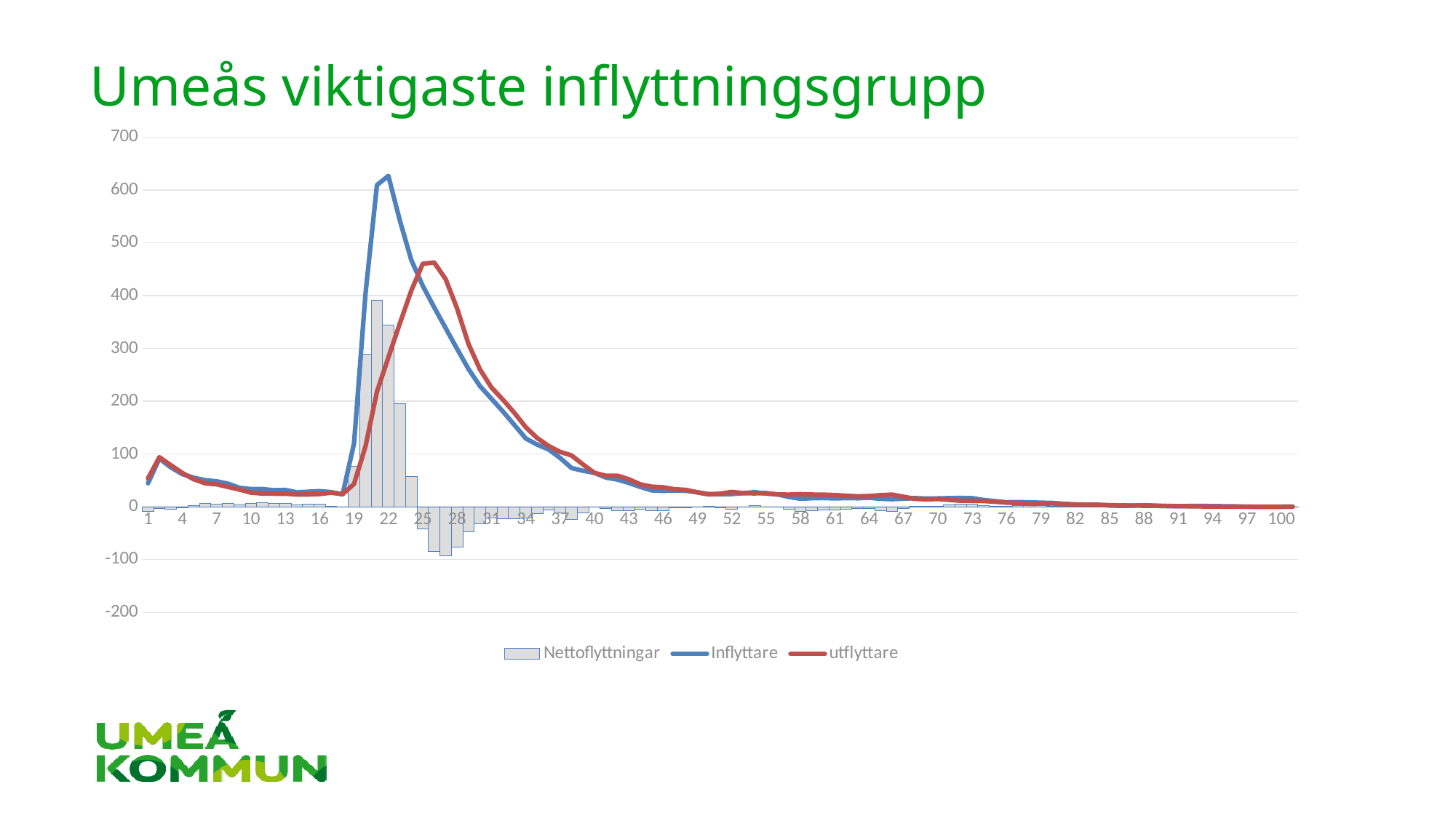
What is the title of the slide containing the chart? Umeås viktigaste inflyttningsgrupp Is the Nettoflyttningar value at x = 27 greater or less than 0? less Is the peak value of the utflyttare line greater or less than 500? less How many series does the legend list? 3 Which series reaches the highest peak in the chart, Inflyttare or utflyttare? Inflyttare Is the peak value of the utflyttare line greater or less than 400? greater Does the Inflyttare line rise or fall between x = 25 and x = 40? fall Which series is drawn as bars in the chart? Nettoflyttningar What kind of chart is shown on the slide? A combined bar and line chart At x = 22, which line is higher, Inflyttare or utflyttare? Inflyttare At x = 28, which line is higher, Inflyttare or utflyttare? utflyttare